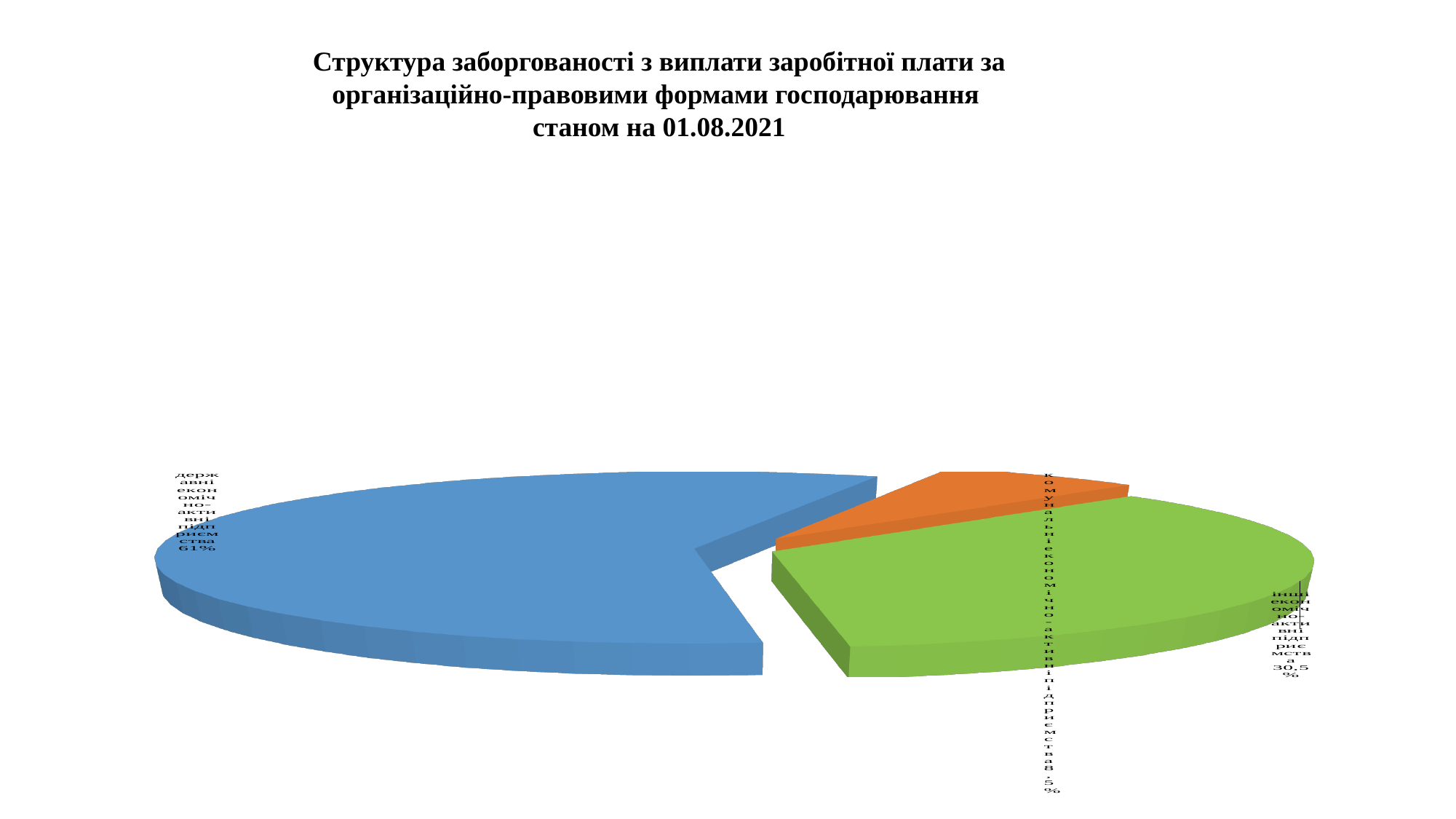
What kind of chart is shown on the slide? pie chart What is the difference in percentage points between the share for інші економічно-активні підприємства and the share for комунальні економічно-активні підприємства? 22 What share of the pie is labelled for державні економічно-активні підприємства? 61% What share of the pie is labelled for інші економічно-активні підприємства? 30,5% What share of the pie is labelled for комунальні економічно-активні підприємства? 8,5% What date is given in the chart title? 01.08.2021 How many slices does the pie chart have? 3 Which is larger: the share for інші економічно-активні підприємства or for комунальні економічно-активні підприємства? інші економічно-активні підприємства What colour is the slice for державні економічно-активні підприємства? blue Which category has the smallest slice of the pie? комунальні економічно-активні підприємства What is the difference in percentage points between the share for державні економічно-активні підприємства and the share for інші економічно-активні підприємства? 30,5 Which category has the largest slice of the pie? державні економічно-активні підприємства